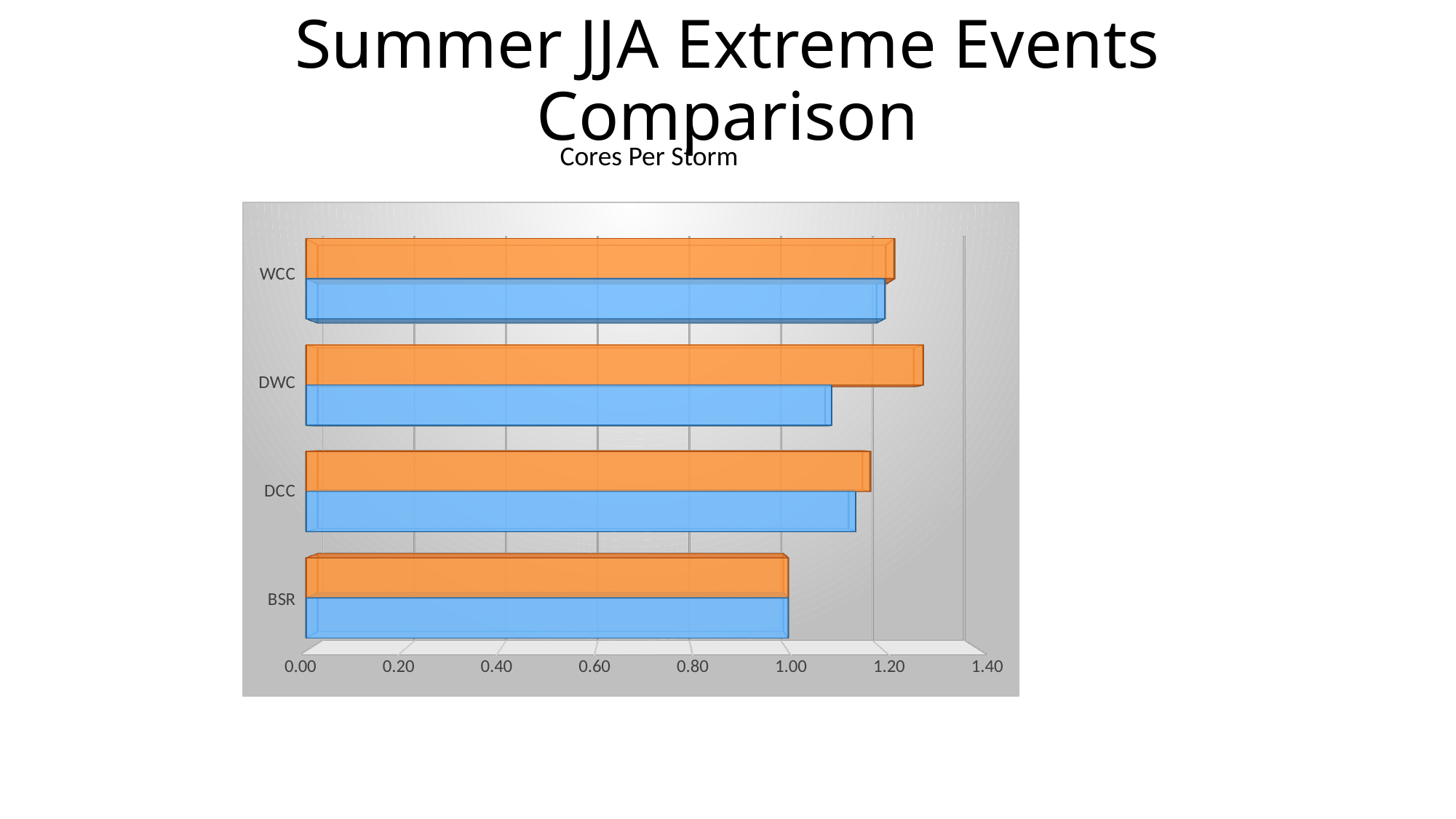
Which category has the shortest blue bar? BSR Which category has the longest orange bar? DWC Is the orange bar for DWC greater or less than 1.20? greater What type of chart is shown on the slide? Bar chart Is the blue bar for BSR greater or less than 1.20? less Which category has the shortest orange bar? BSR For DWC, which bar is longer, the orange bar or the blue bar? Orange Is the blue bar for DWC greater or less than 1.20? less How many series are plotted for each category? 2 What is the title of the chart? Cores Per Storm How many categories are shown on the chart? 4